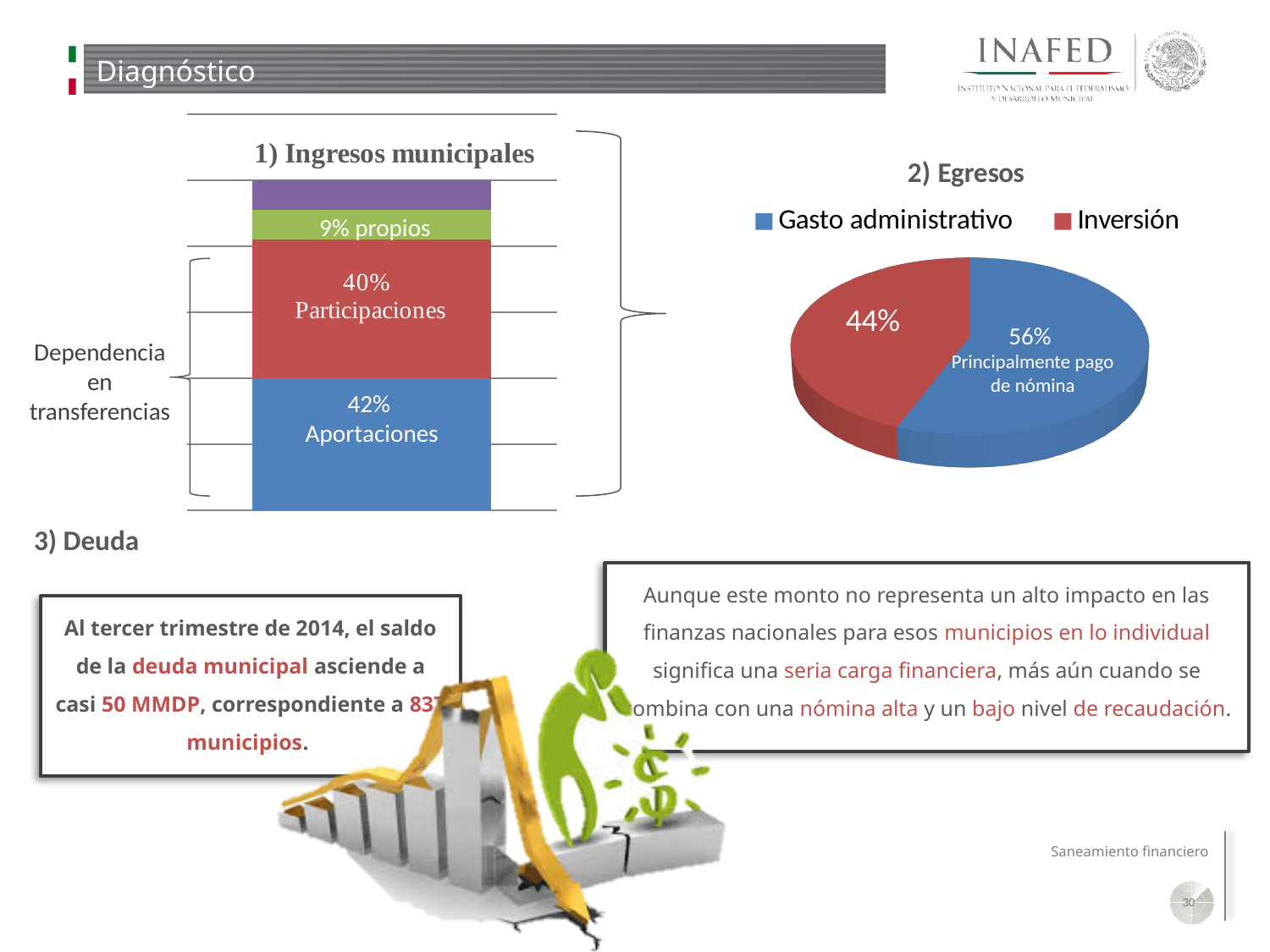
In the "2) Egresos" chart, what share is Gasto administrativo? 56% In the "2) Egresos" chart, what share is Inversión? 44% In the "1) Ingresos municipales" chart, what percentage is Participaciones? 40% In the "1) Ingresos municipales" chart, what percentage is Aportaciones? 42% In the "2) Egresos" chart, what note is written inside the 56% slice? Principalmente pago de nómina In the "1) Ingresos municipales" chart, what is the combined percentage of Participaciones and Aportaciones? 82% In the "1) Ingresos municipales" chart, which labelled segment is the largest? Aportaciones In the "2) Egresos" chart, which slice is larger, Gasto administrativo or Inversión? Gasto administrativo In the "1) Ingresos municipales" chart, what percentage is labelled propios? 9% How many series does the legend of the "2) Egresos" chart list? 2 What kind of chart is "2) Egresos"? Pie chart In the "2) Egresos" chart, what is the difference in percentage points between Gasto administrativo and Inversión? 12